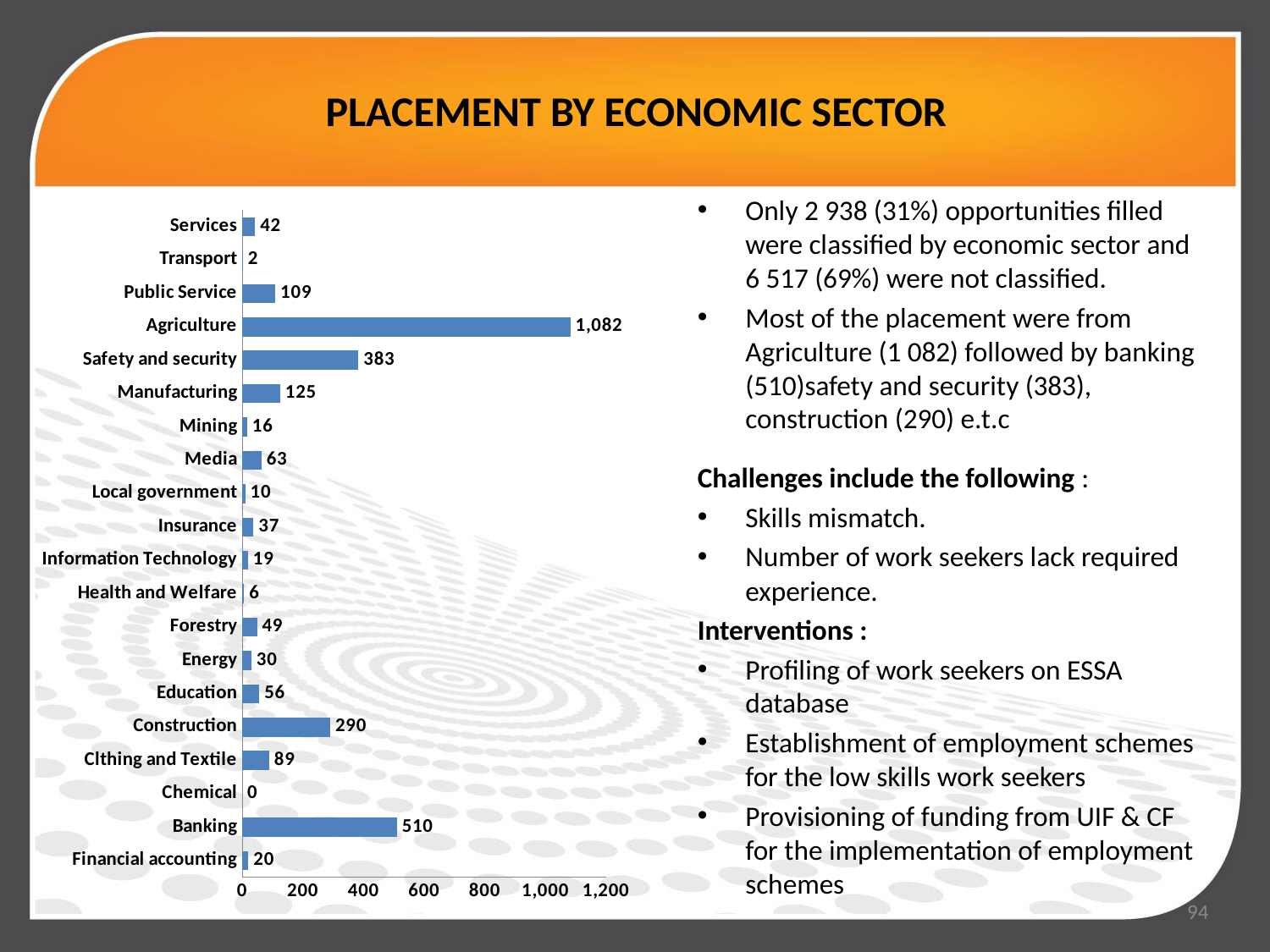
What is the title of the slide containing the chart? PLACEMENT BY ECONOMIC SECTOR Which economic sector has the lowest placement value? Chemical What is the placement value for Banking? 510 What is the placement value for Safety and security? 383 What kind of chart is shown on the slide? Bar chart What is the difference between the placement values for Agriculture and Banking? 572 What is the placement value for Agriculture? 1,082 How many economic sectors are shown in the chart? 20 Which has a larger placement value, Manufacturing or Public Service? Manufacturing What is the placement value for Construction? 290 What is the placement value for Clthing and Textile? 89 Which economic sector has the highest placement value? Agriculture